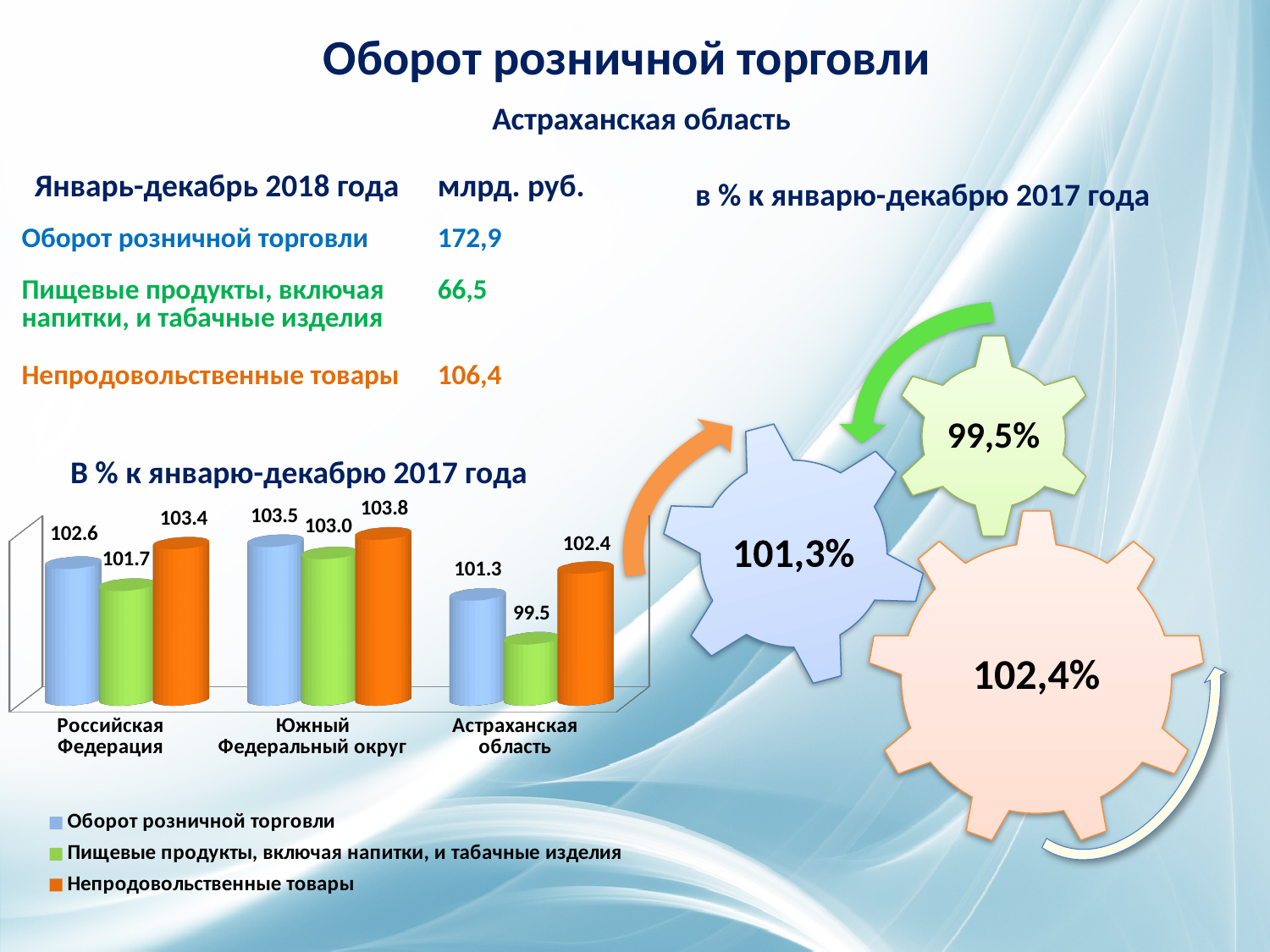
What is the value of Непродовольственные товары for Российская Федерация? 103.4 How many categories are shown on the x axis of the chart? 3 How many series does the chart legend list? 3 What is the difference between the Непродовольственные товары value and the Пищевые продукты value for Астраханская область? 2.9 What is the difference between the Оборот розничной торговли values for Южный Федеральный округ and Астраханская область? 2.2 What is the value of Оборот розничной торговли for Астраханская область? 101.3 Which category has the lowest value for Пищевые продукты, включая напитки, и табачные изделия? Астраханская область What is the title of the bar chart? В % к январю-декабрю 2017 года What is the value of Пищевые продукты, включая напитки, и табачные изделия for Южный Федеральный округ? 103.0 What type of chart is shown on the slide? Bar chart Which is larger: Оборот розничной торговли for Российская Федерация or for Южный Федеральный округ? Южный Федеральный округ Which category has the highest value for Непродовольственные товары? Южный Федеральный округ